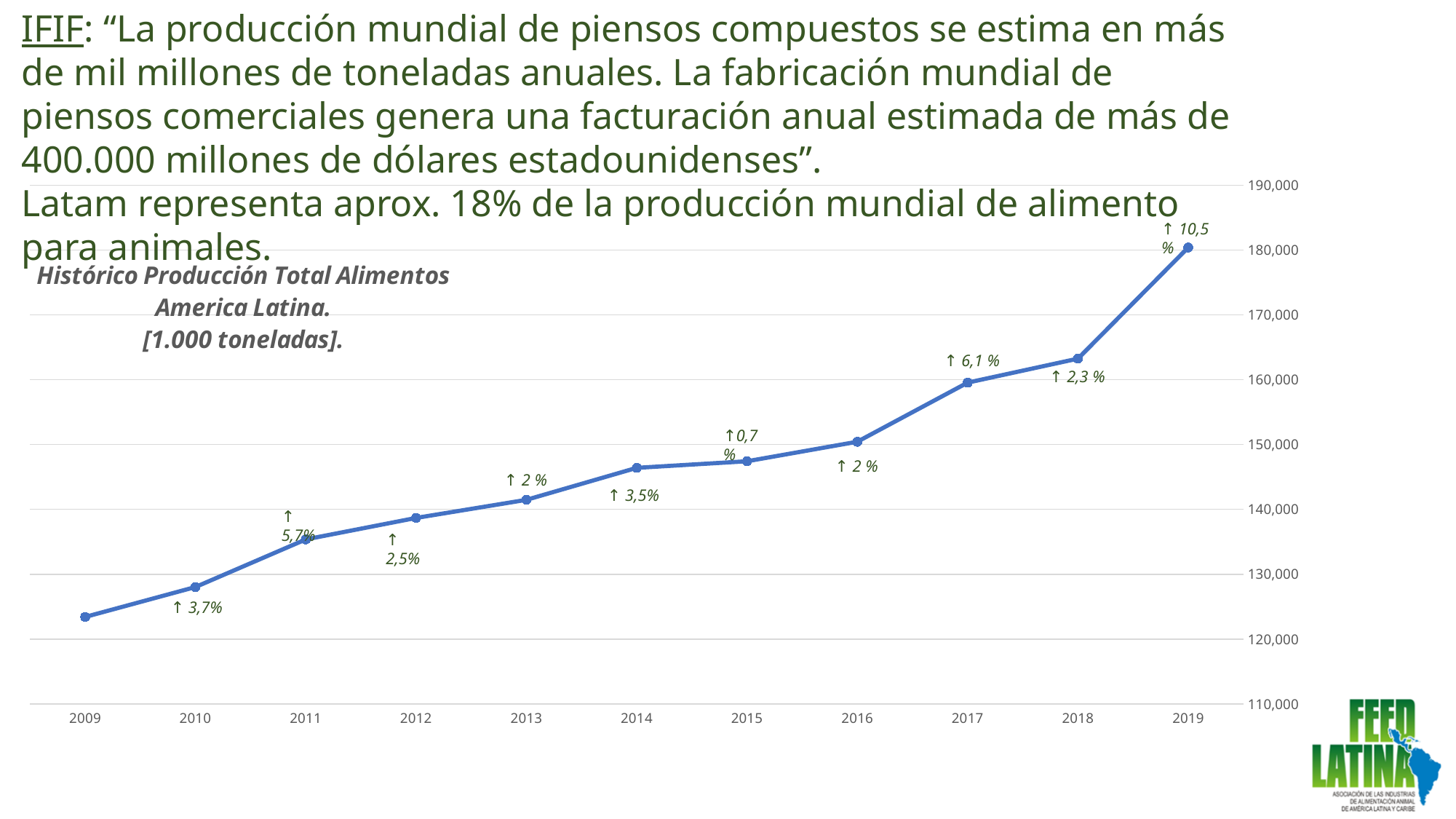
Is the value for 2014 greater or less than 140,000? greater Which year has the larger plotted value, 2012 or 2013? 2013 What is the title of the chart? Histórico Producción Total Alimentos America Latina. [1.000 toneladas]. Which year has the highest plotted value? 2019 Do the plotted values rise or fall from 2009 to 2019? rise What percentage increase is labelled next to the 2019 data point? 10,5 % What percentage increase is labelled next to the 2010 data point? 3,7% Is the value for 2009 greater or less than 130,000? less Is the value for 2019 greater or less than 170,000? greater Which year has the lowest plotted value? 2009 What kind of chart is shown on the slide? line chart How many years are plotted on the x axis of the chart? 11